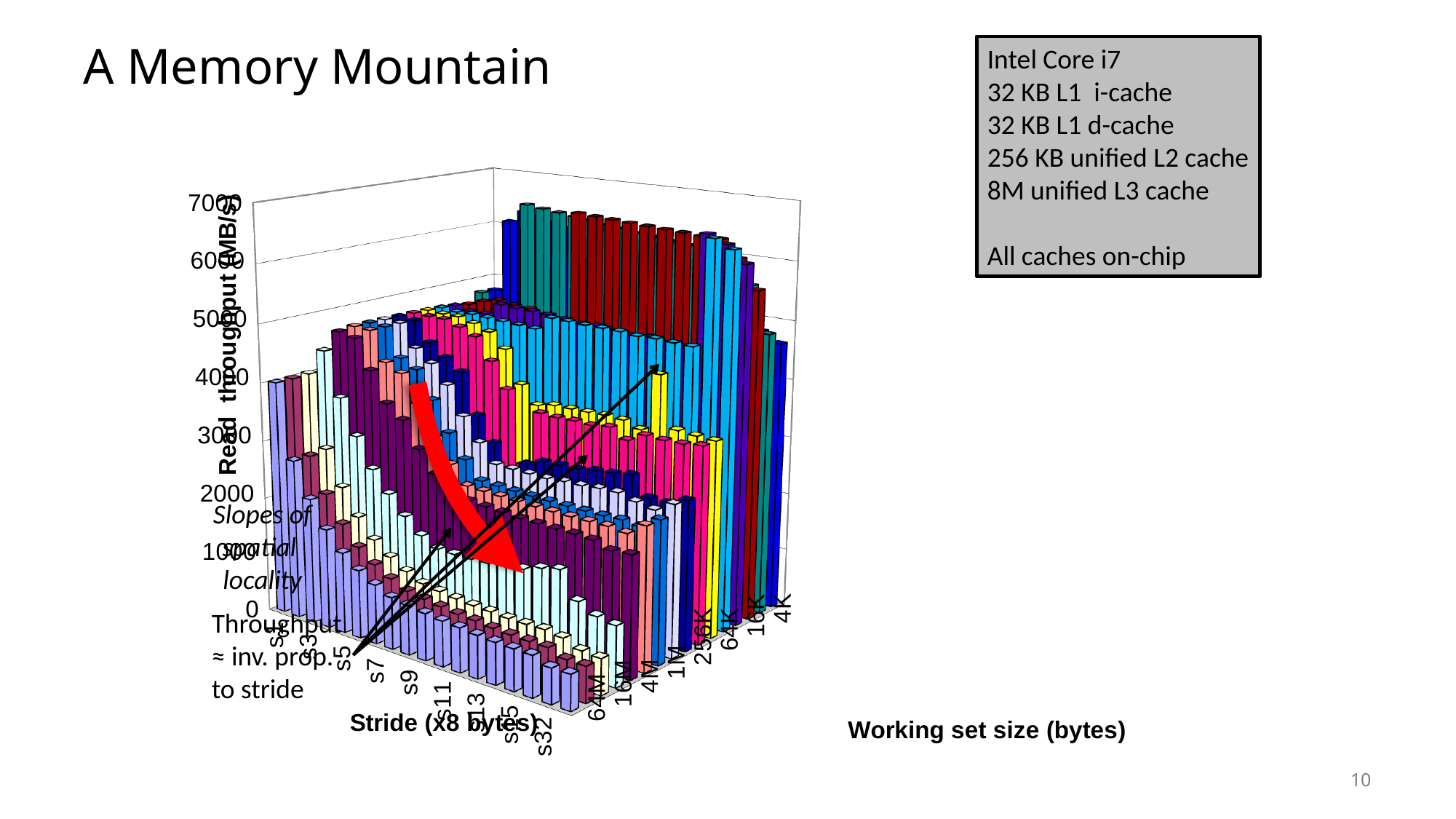
How many working set size labels are shown along the working set axis? 8 Is the bar for stride s32 at working set size 64M greater or less than 2000 MB/s? less What kind of chart is shown on the slide? 3D bar chart At stride s1, which working set size has the higher read throughput, 4K or 64M? 4K Is the tallest bar in the chart greater or less than 5000 MB/s? greater For the 64M working set, does read throughput rise or fall as the stride increases from s1 to s32? fall Which working set size has the lowest read throughput at stride s32, 64M or 4K? 64M At stride s1, does read throughput rise or fall as the working set size decreases from 64M to 4K? rise Is the bar for stride s1 at working set size 64M greater or less than 5000 MB/s? less What is the label of the vertical axis of the chart? Read throughput (MB/s) What is the title of the slide containing the chart? A Memory Mountain